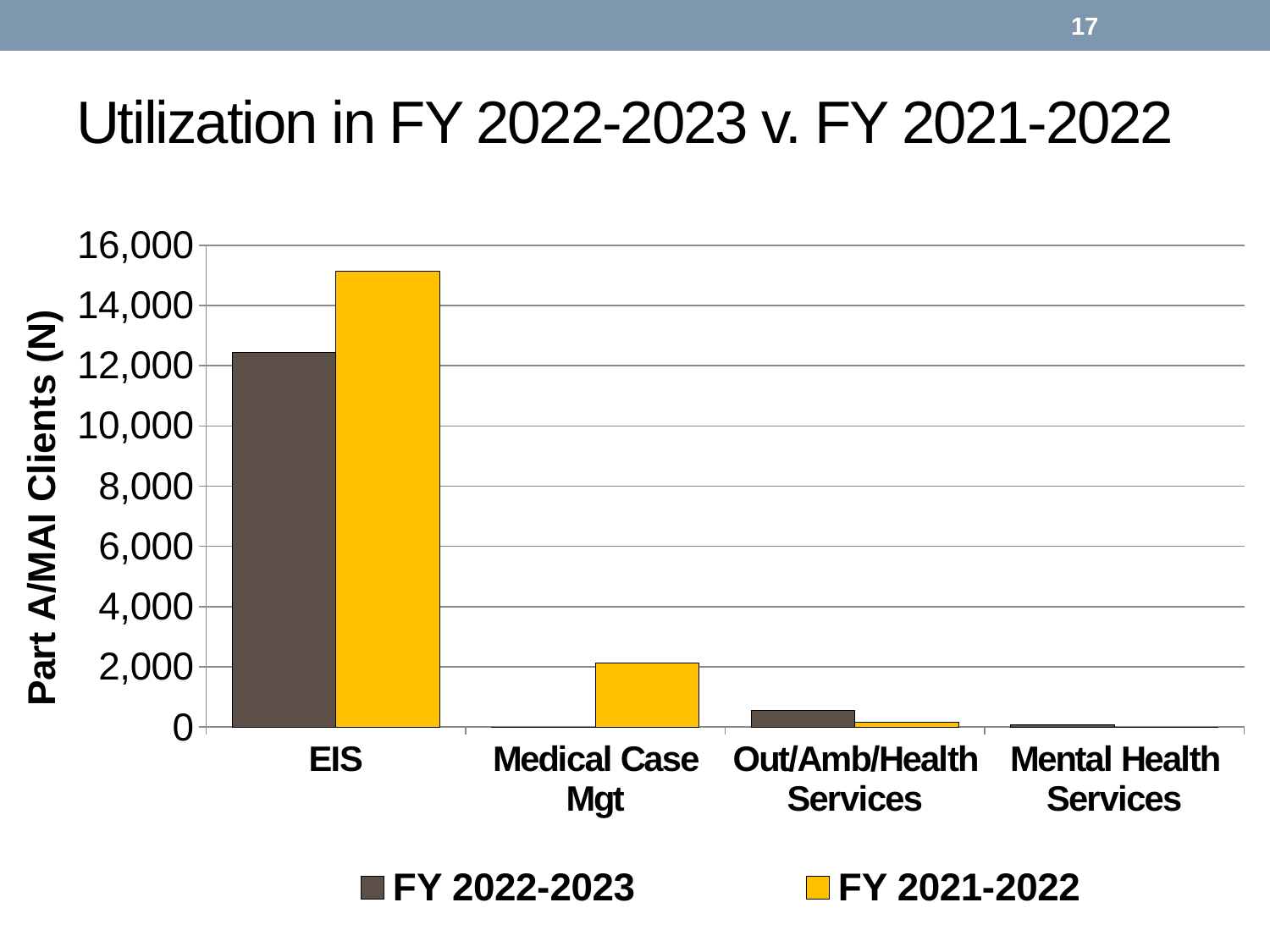
How many service categories are shown on the x axis? 4 For Medical Case Mgt, which series is larger, FY 2022-2023 or FY 2021-2022? FY 2021-2022 Is the FY 2021-2022 value for EIS greater or less than 14,000? greater How many series does the legend list? 2 For EIS, which series is larger, FY 2022-2023 or FY 2021-2022? FY 2021-2022 Which category has the highest value for FY 2021-2022? EIS Which category has the highest value for FY 2022-2023? EIS Is the FY 2021-2022 value for Medical Case Mgt greater or less than 4,000? less What kind of chart is shown on the slide? bar chart For Out/Amb/Health Services, which series is larger, FY 2022-2023 or FY 2021-2022? FY 2022-2023 What is the label on the vertical axis? Part A/MAI Clients (N) Is the FY 2022-2023 value for EIS greater or less than 14,000? less